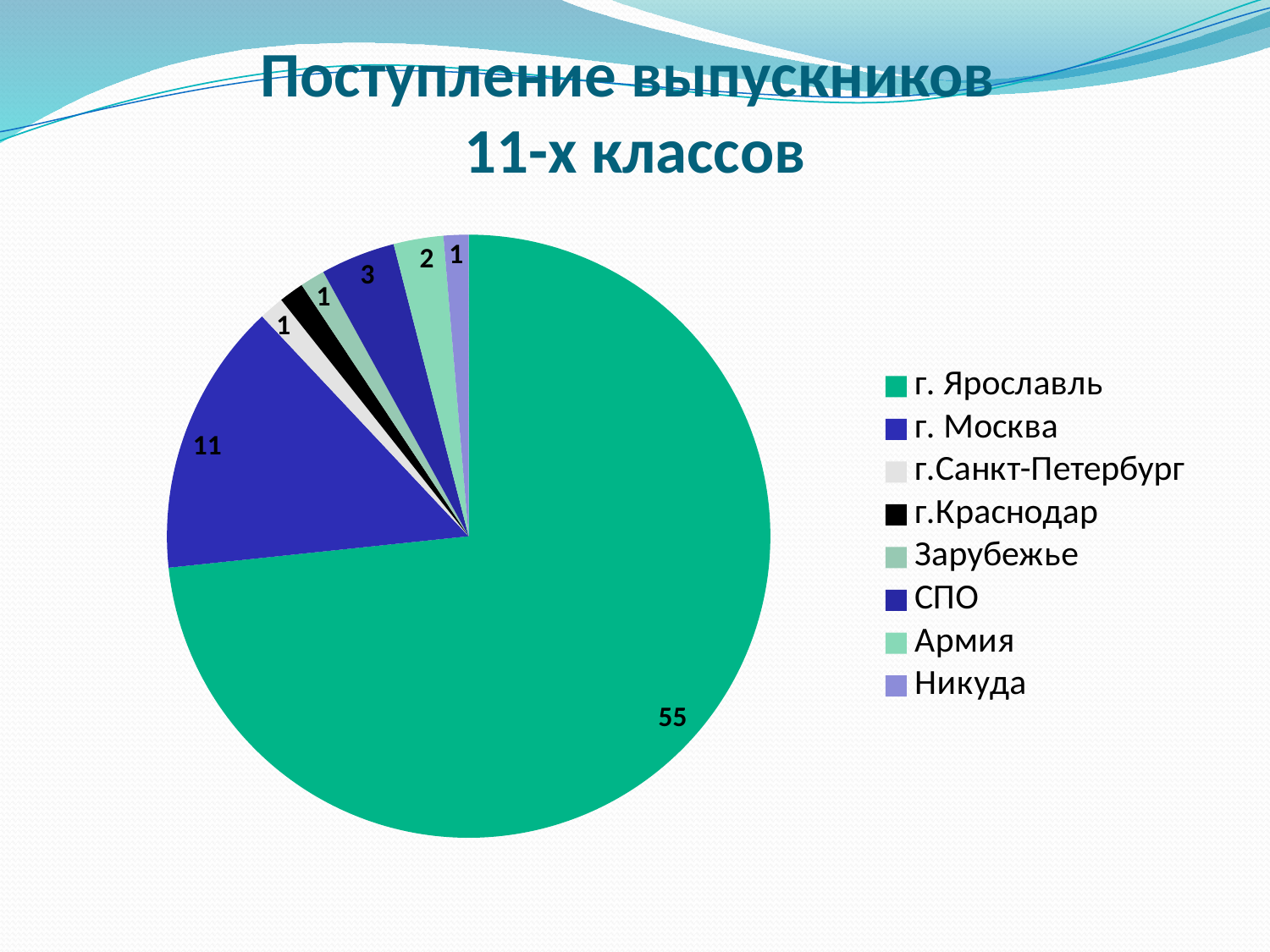
What is the value for г. Москва? 11 What is the title of the chart on the slide? Поступление выпускников 11-х классов How many categories does the pie chart have? 8 What kind of chart is shown on the slide? pie chart Which is larger, the value for СПО or the value for Армия? СПО What is the value for г.Краснодар? 1 What is the value for г. Ярославль? 55 What is the difference between the values for г. Ярославль and г. Москва? 44 What is the total of all the slices in the pie chart? 75 Which category has the largest slice of the pie? г. Ярославль What is the value for СПО? 3 What is the value for Армия? 2